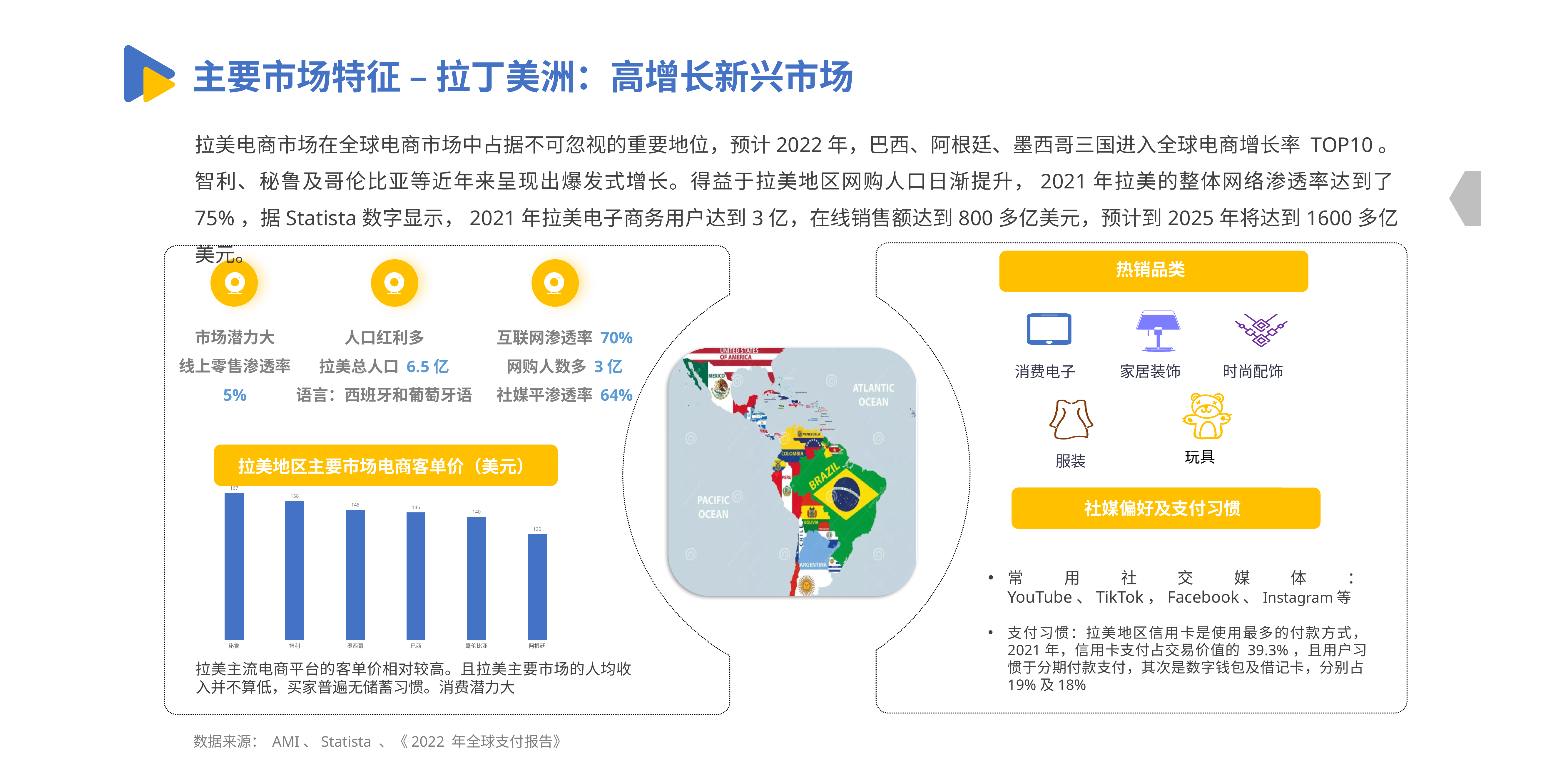
What kind of chart is used to show the e-commerce average order values? Bar chart What value does the bar for 阿根廷 show? 120 Which market has the highest value in the bar chart? 秘鲁 Do the bar values rise or fall from left to right across the chart? Fall What is the difference between the values for 秘鲁 and 阿根廷? 47 Which has a larger value, 哥伦比亚 or 智利? 智利 What is the difference between the values for 智利 and 巴西? 13 What is the title of the bar chart? 拉美地区主要市场电商客单价（美元） Which market has the lowest value in the bar chart? 阿根廷 How many markets are shown in the bar chart? 6 What is the e-commerce average order value shown for 秘鲁 in the chart? 167 What value is labelled on the bar for 墨西哥? 148